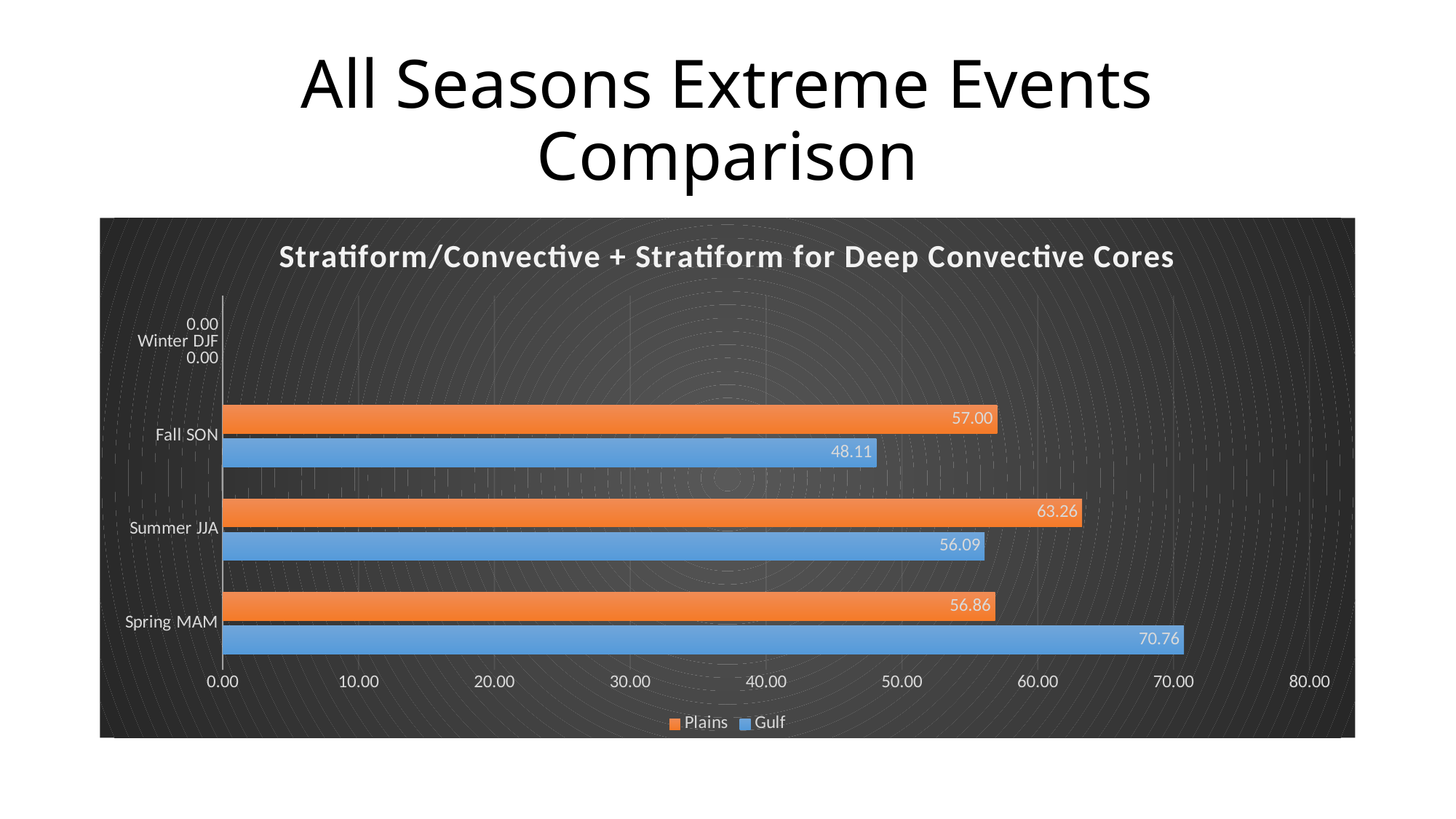
What is the Gulf value for Spring MAM? 70.76 Which season has the lowest Gulf value? Winter DJF What is the Gulf value for Summer JJA? 56.09 Is the Gulf value for Fall SON greater or less than 50.00? less What is the difference between the Gulf and Plains values for Spring MAM? 13.90 What type of chart is shown on the slide? Bar chart What is the Plains value for Winter DJF? 0.00 Which season has the highest Plains value? Summer JJA How many seasons are shown on the chart? 4 For Fall SON, which series has the larger value, Plains or Gulf? Plains What is the Plains value for Fall SON? 57.00 How many series does the legend list? 2